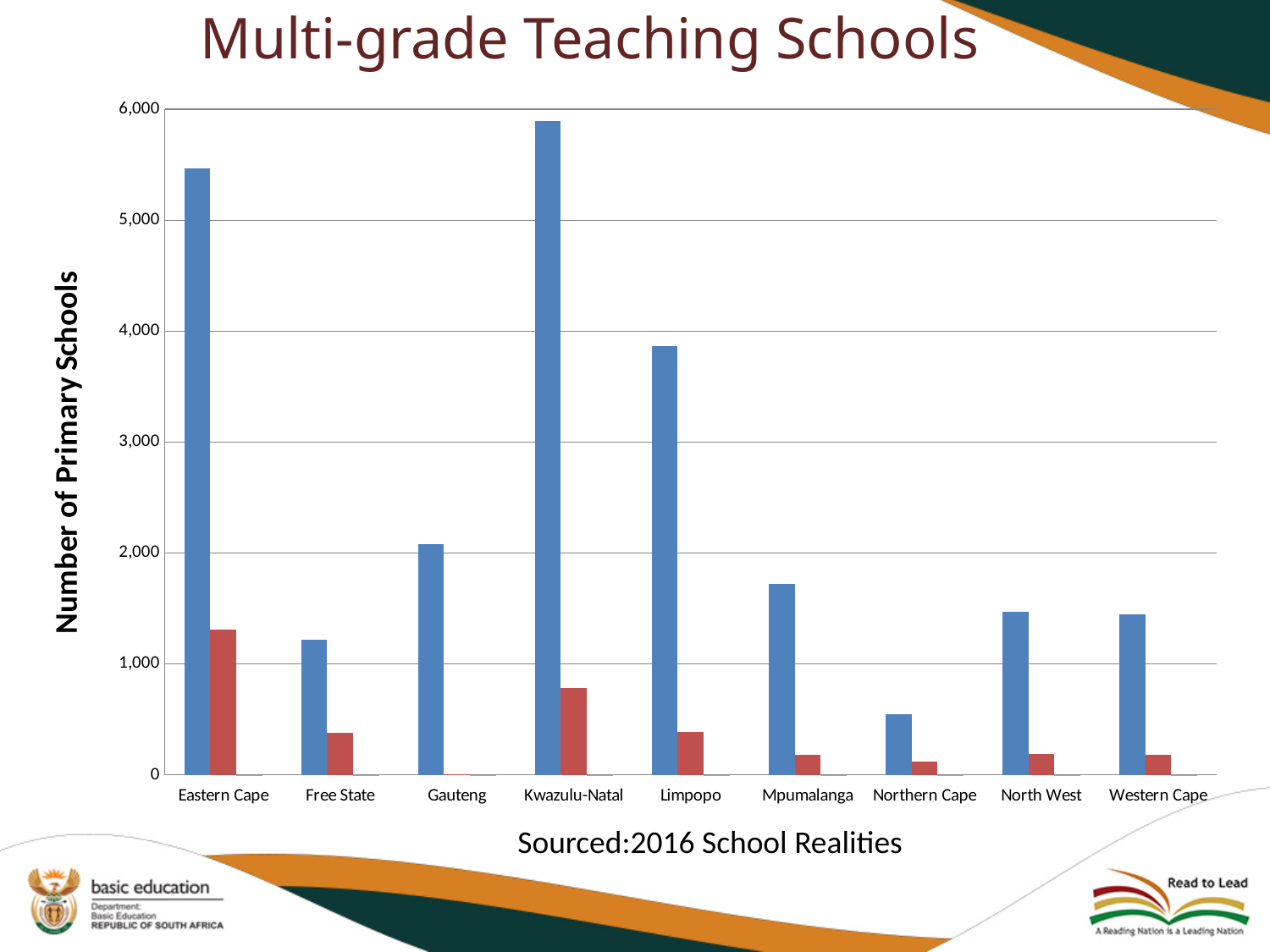
Which province has the shortest blue bar? Northern Cape What is the title of the chart? Multi-grade Teaching Schools Is the blue bar for Limpopo greater or less than 4,000? less What type of chart is shown on the slide? bar chart Is the red bar for Kwazulu-Natal greater or less than 1,000? less Which has the larger blue bar, Gauteng or Limpopo? Limpopo Which province has the tallest red bar? Eastern Cape How many provinces are shown on the x axis of the chart? 9 Which province has the tallest blue bar? Kwazulu-Natal Is the blue bar for Northern Cape greater or less than 1,000? less What is the label on the vertical axis of the chart? Number of Primary Schools